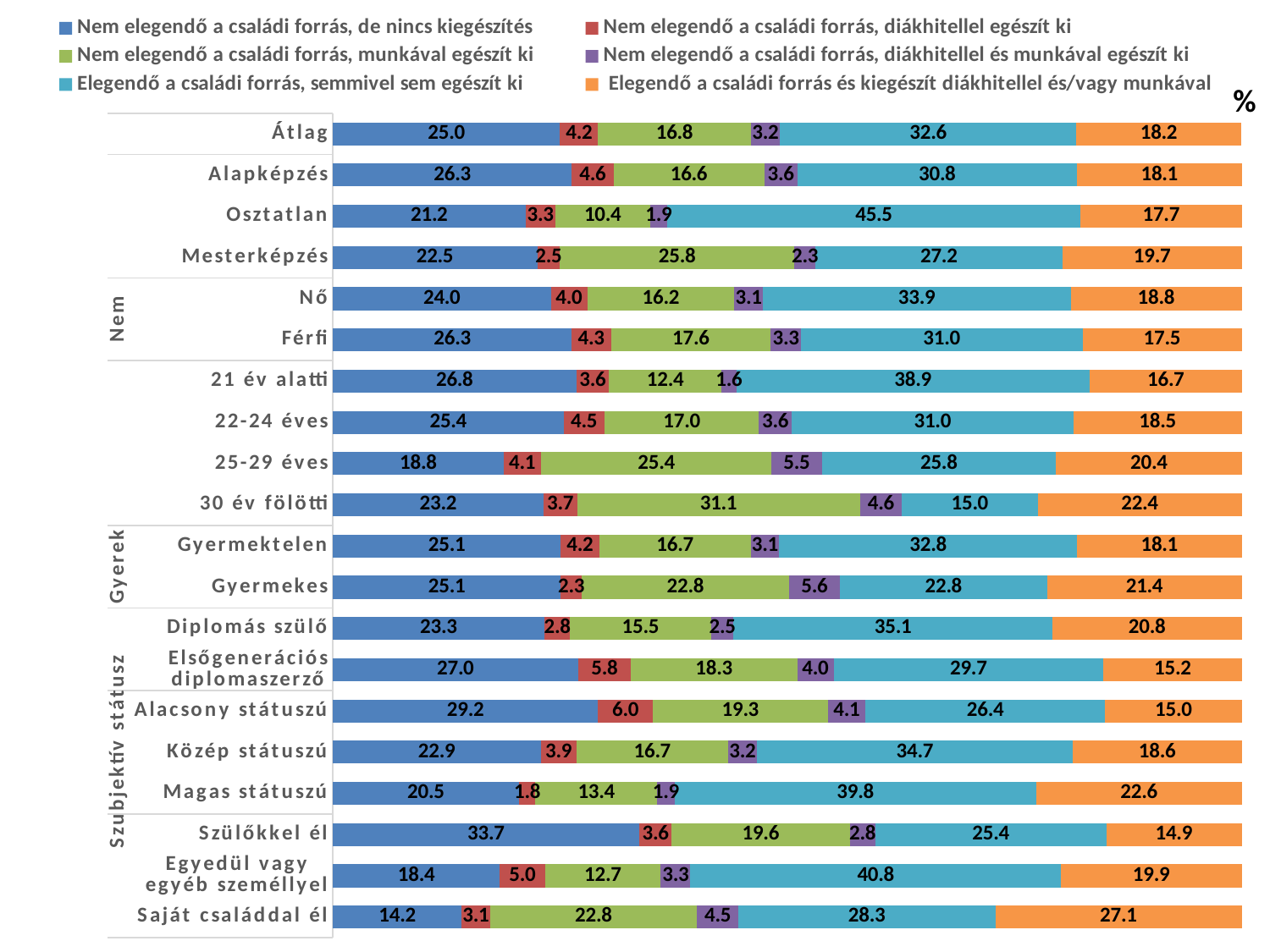
Which category has the highest value for "Nem elegendő a családi forrás, de nincs kiegészítés"? Szülőkkel él What kind of chart is shown on the slide? stacked bar chart Which has the larger value for "Nem elegendő a családi forrás, de nincs kiegészítés": Nő or Férfi? Férfi How many categories (bars) are plotted in the chart? 20 What unit label is shown at the top right of the chart? % Which category has the lowest value for "Nem elegendő a családi forrás, de nincs kiegészítés"? Saját családdal él What is the value of "Nem elegendő a családi forrás, munkával egészít ki" for 30 év fölötti? 31.1 How many series does the legend list? 6 For Átlag, what is the difference between "Elegendő a családi forrás, semmivel sem egészít ki" (32.6) and "Nem elegendő a családi forrás, de nincs kiegészítés" (25.0)? 7.6 Which category has the highest value for "Elegendő a családi forrás, semmivel sem egészít ki"? Osztatlan What is the value of "Elegendő a családi forrás és kiegészít diákhitellel és/vagy munkával" for Saját családdal él? 27.1 What is the value of "Elegendő a családi forrás, semmivel sem egészít ki" for Osztatlan? 45.5